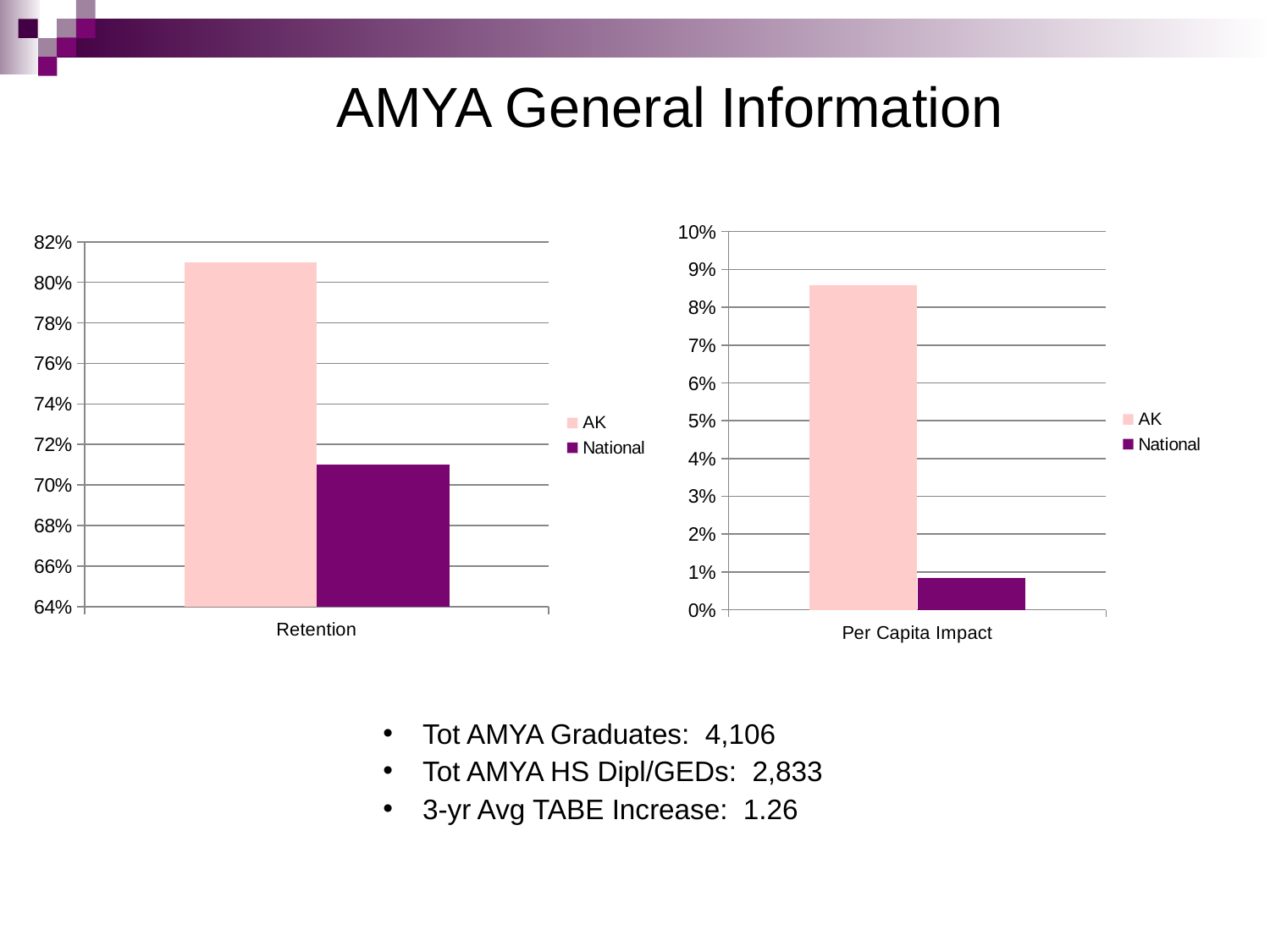
In the left chart (Retention), which series has the higher value, AK or National? AK In the left chart (Retention), how many series does the legend list? 2 In the left chart (Retention), how many categories are shown on the x axis? 1 In the right chart (Per Capita Impact), what are the two series named in the legend? AK and National In the right chart (Per Capita Impact), which series has the lower value, AK or National? National In the left chart (Retention), is the value for National greater or less than 72%? less In the left chart (Retention), is the value for AK greater or less than 80%? greater In the right chart (Per Capita Impact), is the value for National greater or less than 1%? less What kind of chart is the left chart (Retention)? bar chart In the right chart (Per Capita Impact), what colour is the bar for National? dark purple What kind of chart is the right chart (Per Capita Impact)? bar chart